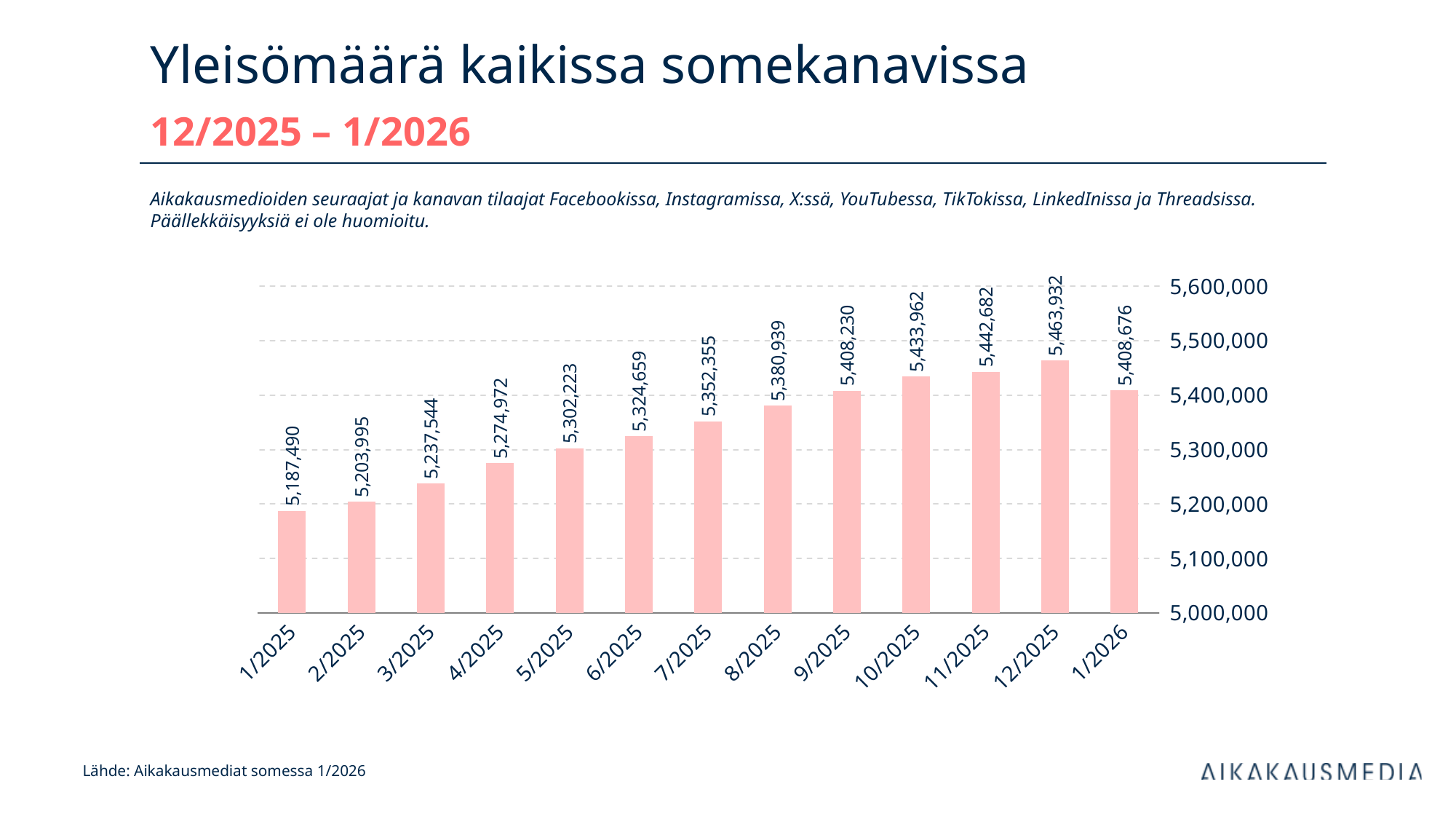
How many months are shown on the x axis? 13 Which is larger, the value for 11/2025 or the value for 1/2026? 11/2025 What is the value for 1/2026? 5,408,676 What is the difference between the values for 12/2025 and 1/2026? 55,256 Which month has the highest value? 12/2025 What kind of chart is shown on the slide? Bar chart What is the value for 1/2025? 5,187,490 What is the value for 12/2025? 5,463,932 What is the value for 6/2025? 5,324,659 What is the difference between the values for 12/2025 and 1/2025? 276,442 Do the values rise or fall from 1/2025 to 12/2025? Rise Which month has the lowest value? 1/2025